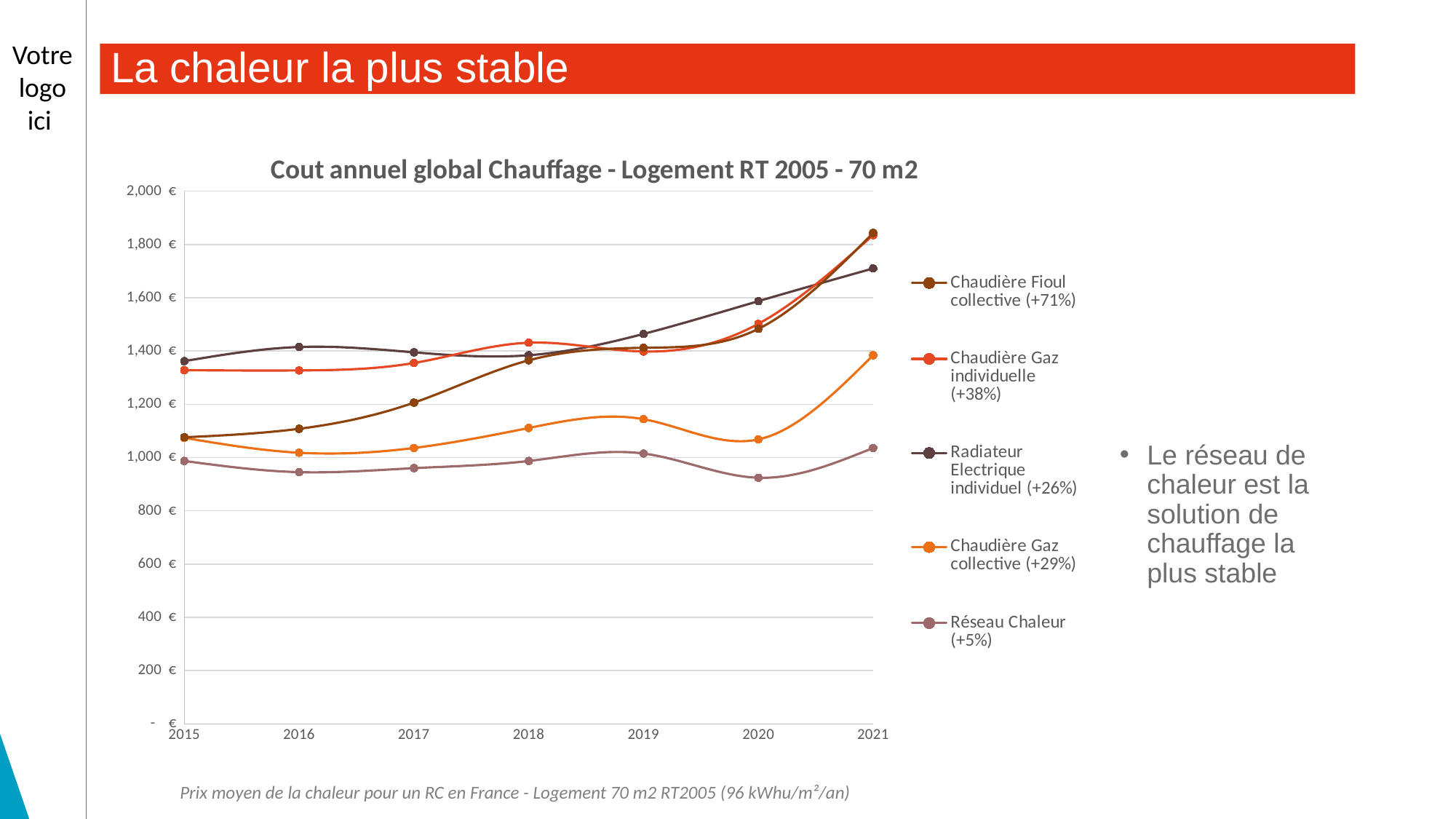
Which series has the highest value in 2020? Radiateur Electrique individuel (+26%) Does the value for Chaudière Fioul collective rise or fall from 2015 to 2021? rise Is the value for Chaudière Fioul collective in 2021 greater or less than 1,600 €? greater What percentage increase does the legend show for Réseau Chaleur? +5% Which series has the lowest value in 2021? Réseau Chaleur (+5%) How many years are plotted along the x axis of the chart? 7 What is the title of the chart? Cout annuel global Chauffage - Logement RT 2005 - 70 m2 Is the value for Réseau Chaleur in 2021 greater or less than 1,200 €? less How many series does the legend of the chart list? 5 In 2015, which is higher: Radiateur Electrique individuel or Chaudière Gaz collective? Radiateur Electrique individuel What kind of chart is shown on the slide? line chart Is the value for Chaudière Gaz collective in 2019 greater or less than 1,200 €? less